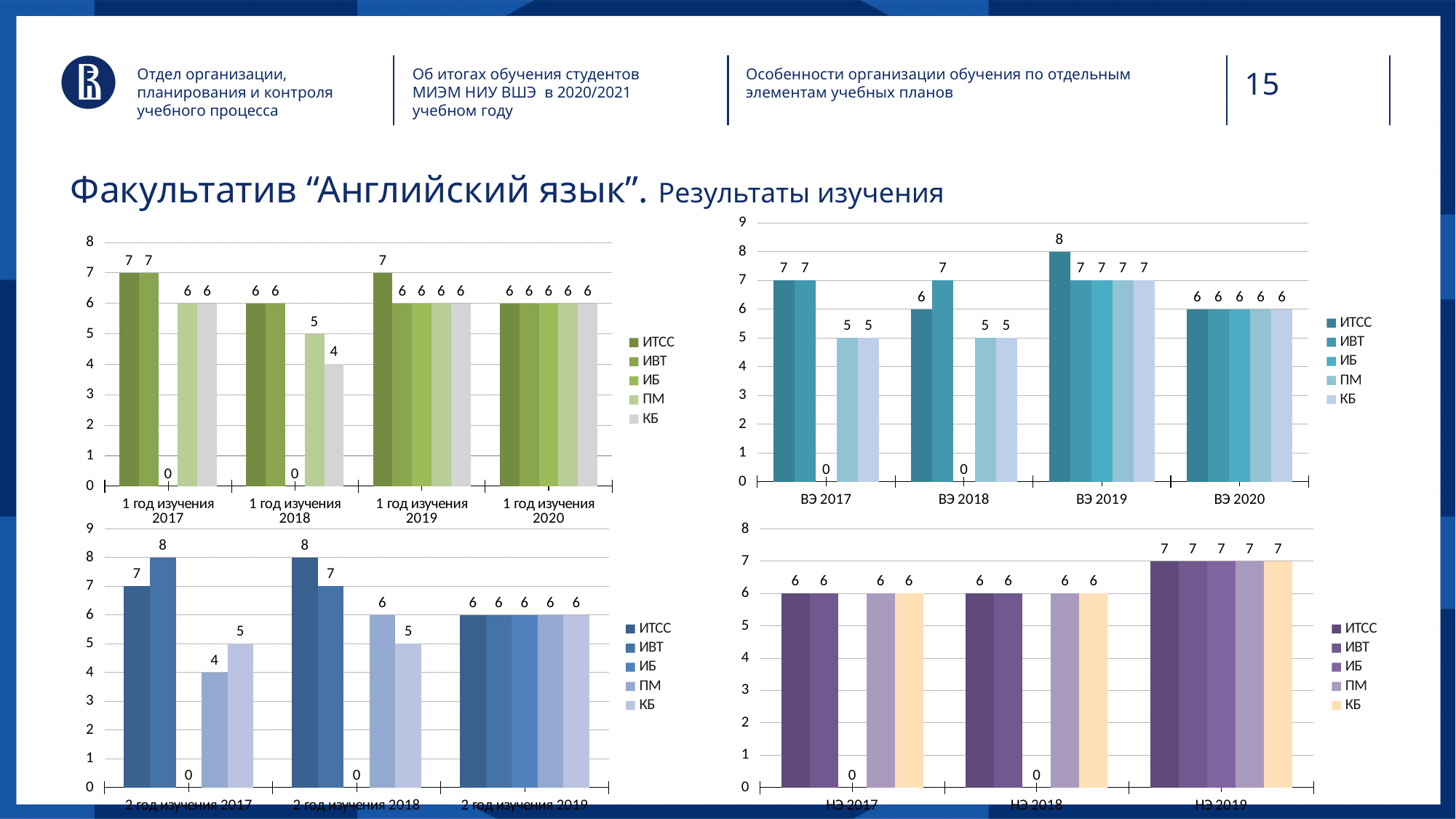
In the bottom-left chart, which is larger for '2 год изучения 2017': ИТСС or ИВТ? ИВТ In the bottom-right chart, what is the value for ИБ in НЭ 2018? 0 In the bottom-right chart, what is the value for КБ in НЭ 2019? 7 In the bottom-left chart, what is the value for ПМ in '2 год изучения 2018'? 6 How many series does the legend of the top-right chart list? 5 In the top-left chart, what is the value for ИБ in '1 год изучения 2017'? 0 In the top-right chart, what is the difference between ИТСС and ПМ for ВЭ 2019? 1 In the top-right chart, how many categories are shown on the x axis? 4 In the bottom-left chart, how many categories are shown on the x axis? 3 In the top-right chart, which series has the highest value for ВЭ 2019? ИТСС What type of chart is the top-left chart? Bar chart In the top-left chart, what is the value for КБ in '1 год изучения 2018'? 4